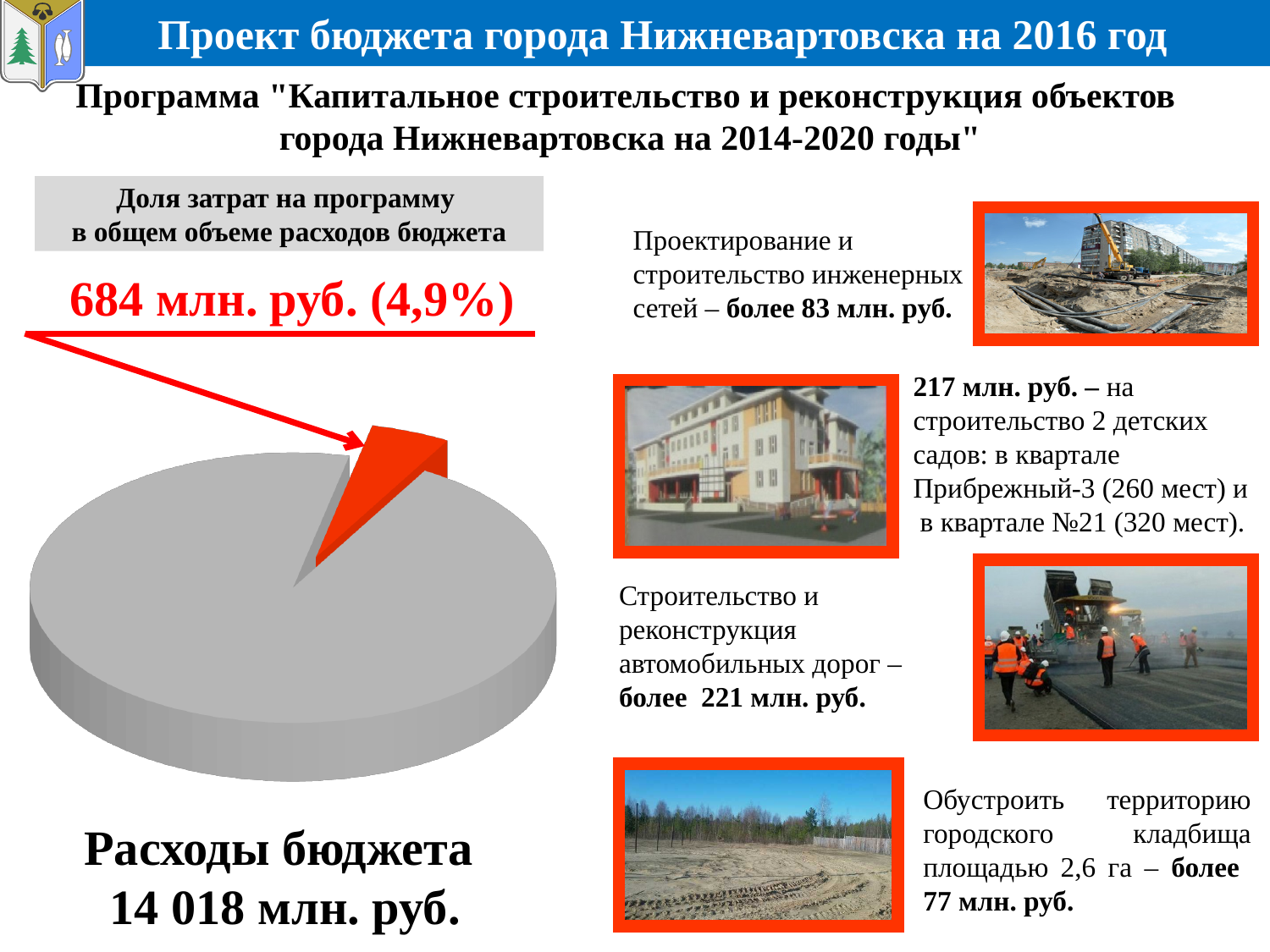
What colour is the slice representing the program's costs in the pie chart? Red What share of the total budget expenditure does the program (red slice) represent according to the pie chart? 4,9% Is the program's share of the budget shown in the pie chart greater or less than 10%? less What kind of chart is shown on the left of the slide? Pie chart Which slice of the pie chart is larger, the red slice or the grey slice? The grey slice By how much does the total budget expenditure (14 018 млн. руб.) exceed the program's costs (684 млн. руб.)? 13 334 млн. руб. What is the title of the pie chart? Доля затрат на программу в общем объеме расходов бюджета What is the value of the highlighted (red) slice of the pie chart? 684 млн. руб. What is the total budget expenditure shown below the pie chart? 14 018 млн. руб. How many slices does the pie chart have? 2